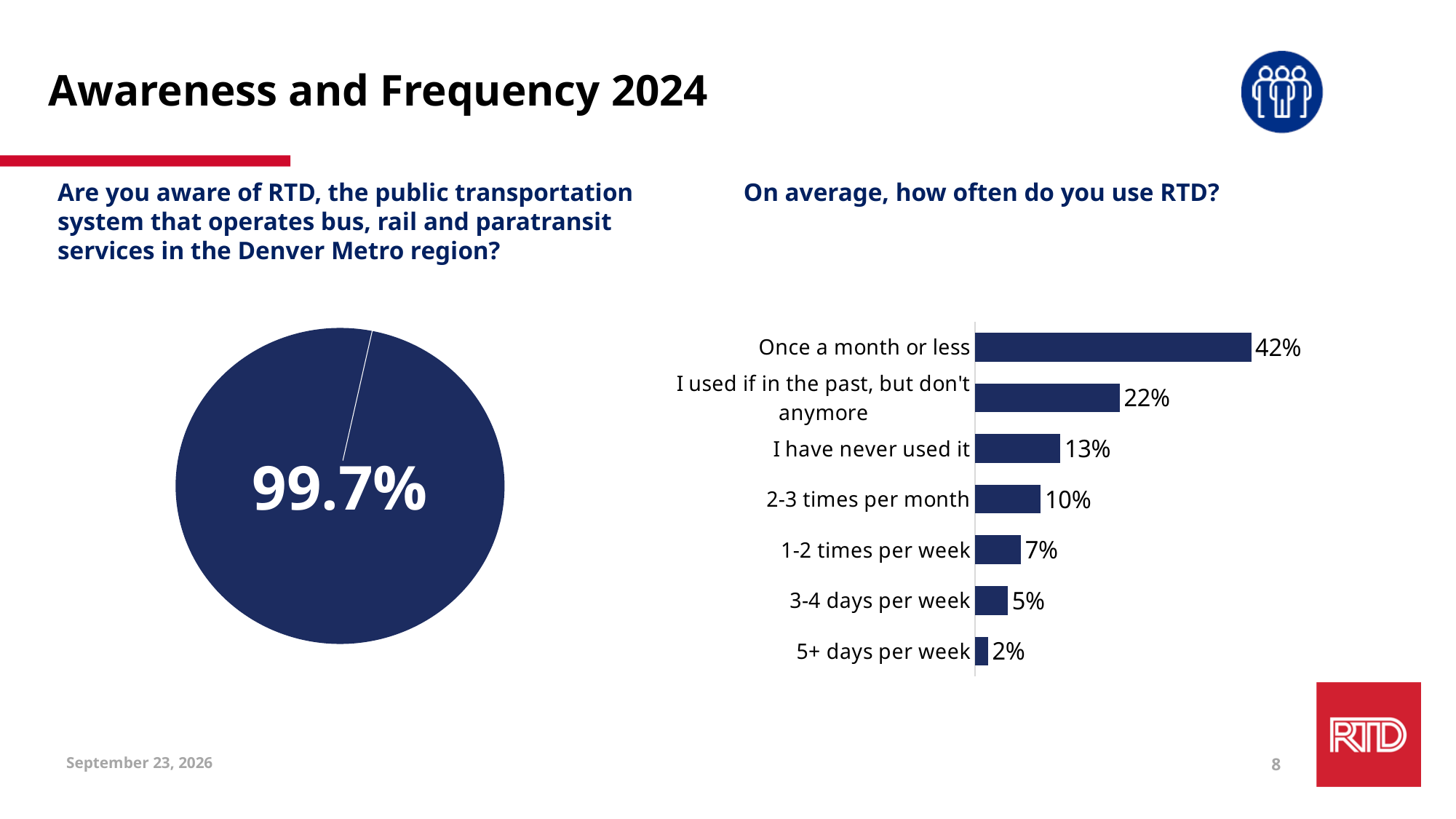
In the pie chart on the left, what percentage is shown as aware of RTD? 99.7% In the 'On average, how often do you use RTD?' chart, which category has the lowest value? 5+ days per week In the 'On average, how often do you use RTD?' chart, what is the combined value of '3-4 days per week' and '5+ days per week'? 7% In the 'On average, how often do you use RTD?' chart, what is the difference between 'Once a month or less' and 'I used if in the past, but don't anymore'? 20% In the 'On average, how often do you use RTD?' chart, what is the value for 'I have never used it'? 13% In the 'On average, how often do you use RTD?' chart, which category has the highest value? Once a month or less In the 'On average, how often do you use RTD?' chart, what percentage of respondents use RTD once a month or less? 42% What kind of chart is shown on the left side of the slide, under the awareness question? Pie chart How many categories are shown in the 'On average, how often do you use RTD?' chart? 7 In the 'On average, how often do you use RTD?' chart, what is the value for '5+ days per week'? 2% In the 'On average, how often do you use RTD?' chart, which is larger: '2-3 times per month' or '1-2 times per week'? 2-3 times per month What kind of chart is used for 'On average, how often do you use RTD?'? Bar chart